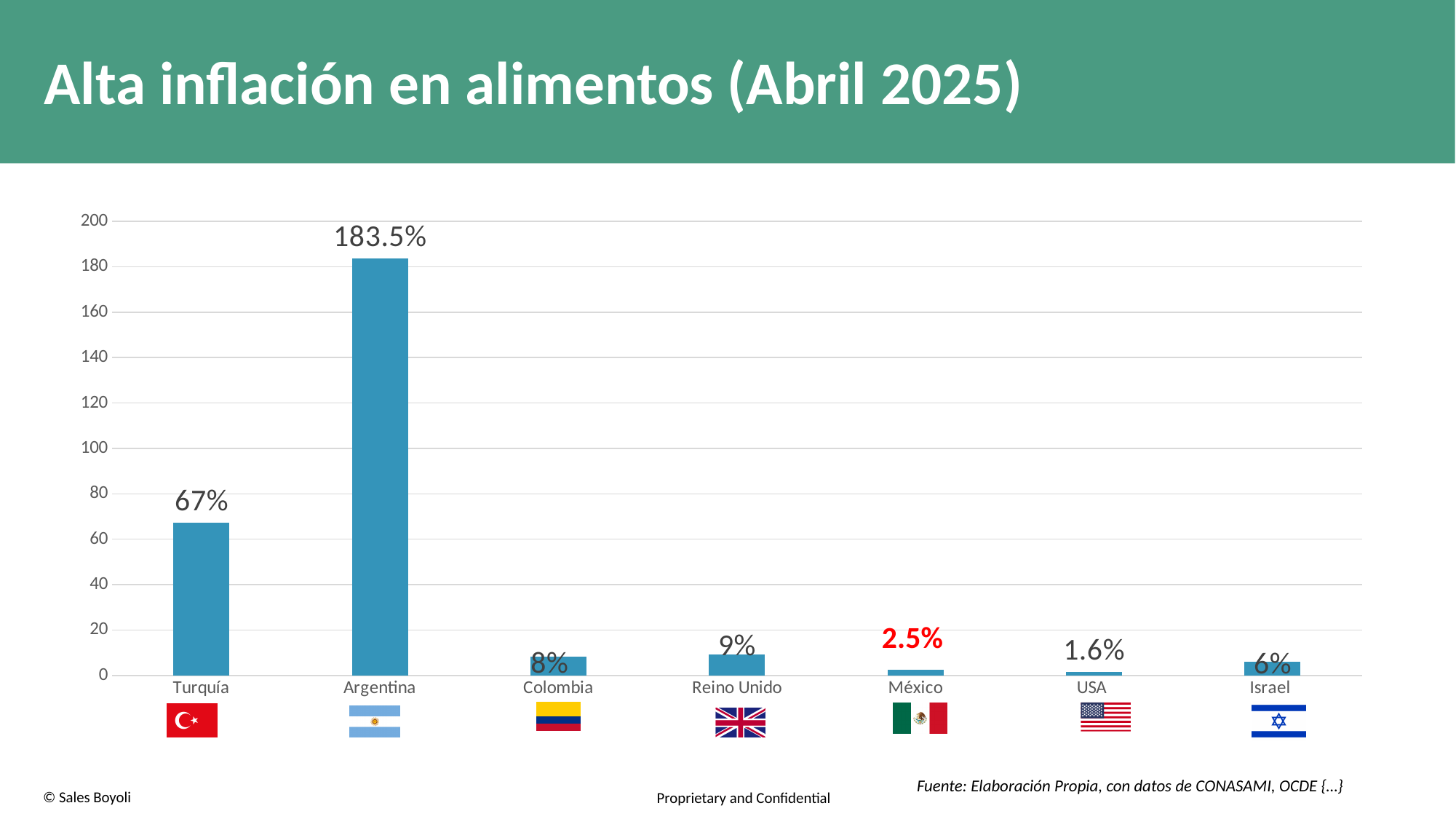
Which country has the highest value? Argentina What is the value for USA? 1.6% Which country has the lowest value? USA Is the value for Turquía greater or less than 60? greater Which is larger, the value for Reino Unido or the value for Colombia? Reino Unido Which country's data label is shown in red? México What is the value for México? 2.5% What is the value for Turquía? 67% What is the difference between the values for Argentina and Turquía? 116.5% What kind of chart is shown on the slide? Bar chart What is the value for Argentina? 183.5% How many countries are shown in the chart? 7